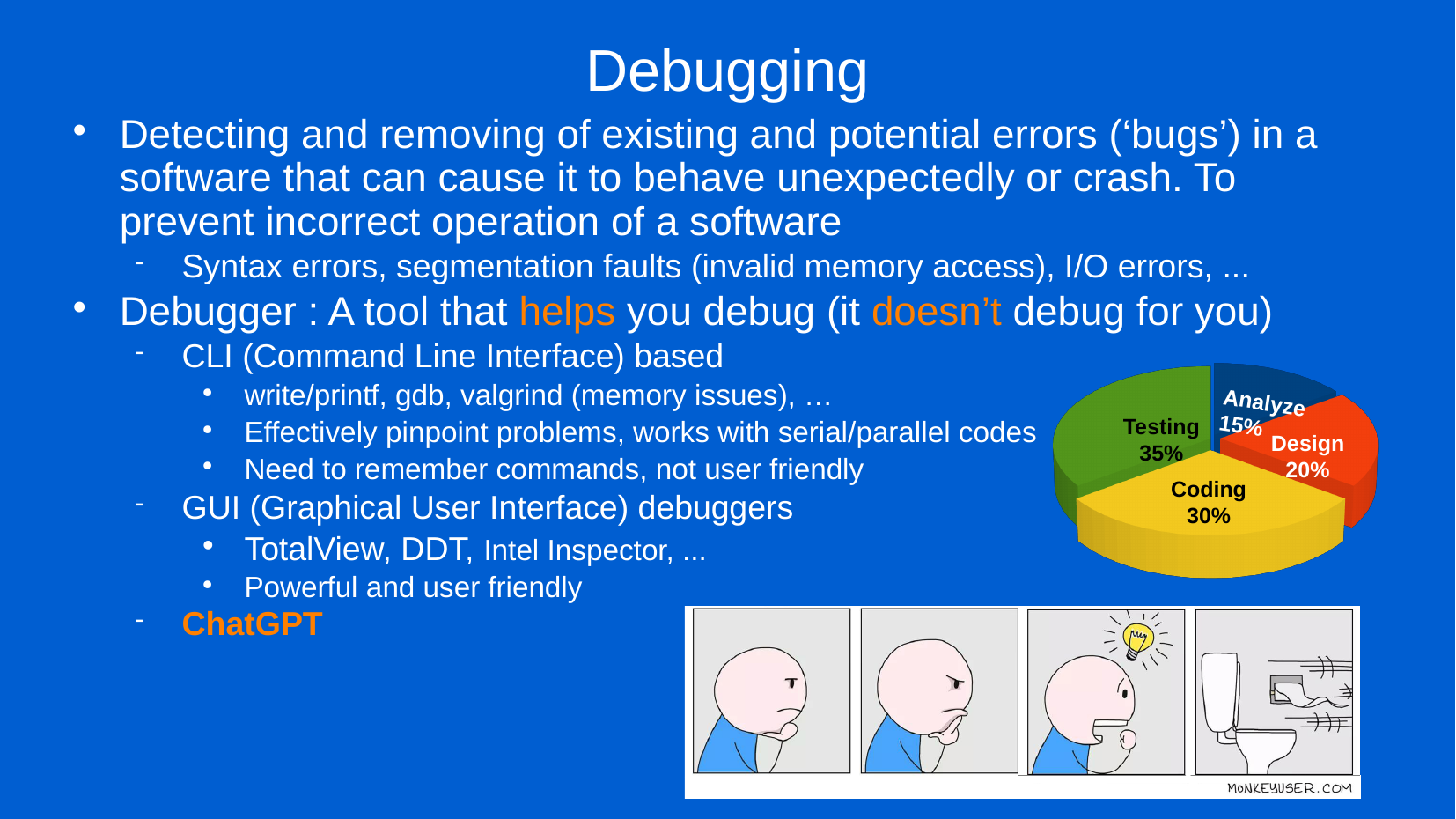
What colour is the Coding slice in the pie chart? yellow Which slice of the pie chart is the largest? Testing What percentage does the Testing slice represent in the pie chart? 35% What is the difference in percentage points between the Testing and Coding slices? 5 What percentage does the Coding slice represent in the pie chart? 30% What percentage does the Analyze slice represent in the pie chart? 15% How many slices does the pie chart have? 4 What percentage does the Design slice represent in the pie chart? 20% Which is larger in the pie chart, Coding or Design? Coding Which slice of the pie chart is the smallest? Analyze What is the difference in percentage points between the Design and Analyze slices? 5 What kind of chart is shown on the slide? pie chart